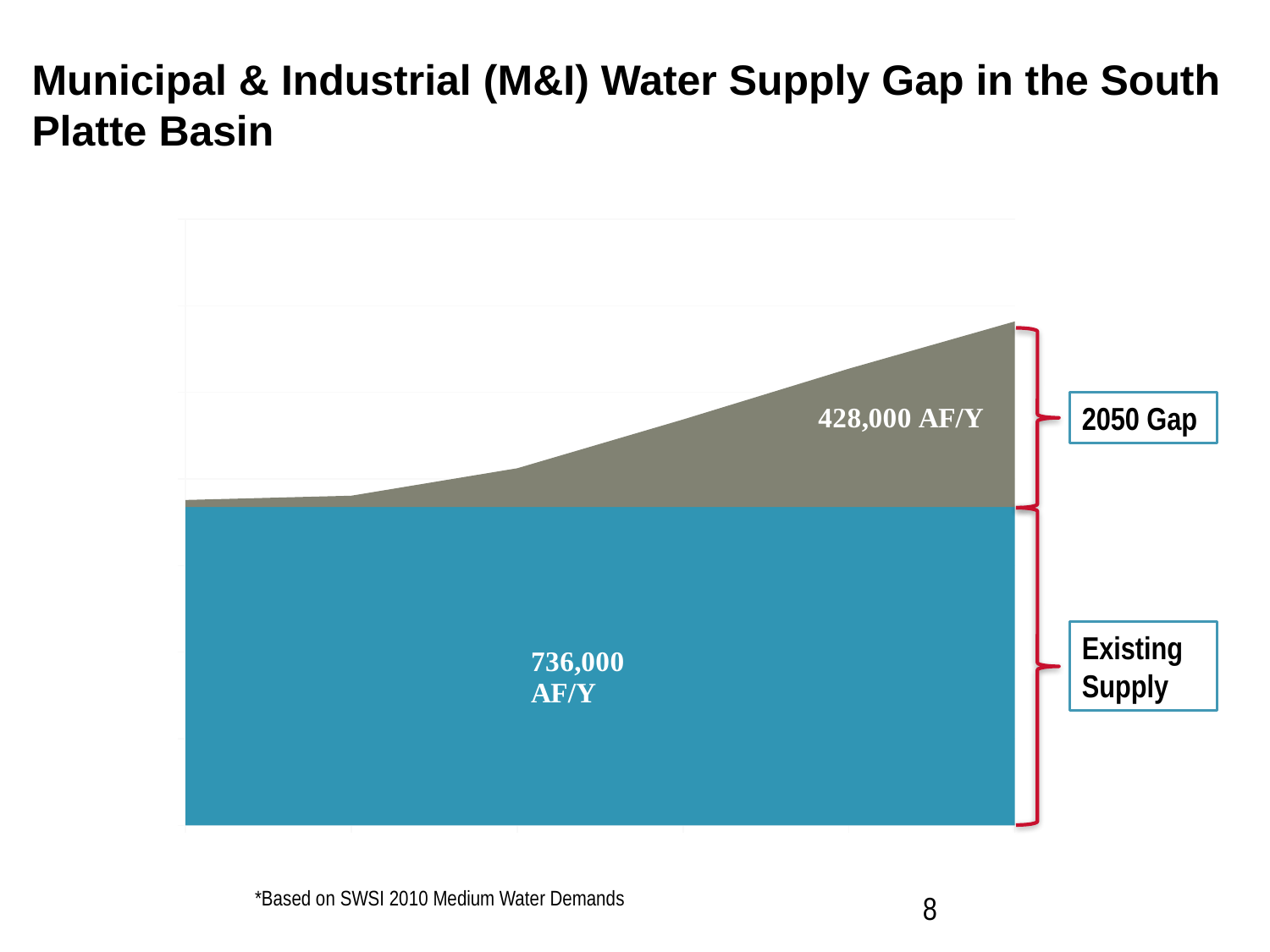
How many series are plotted on the chart? 2 What is the combined total of the Existing Supply and the 2050 Gap shown on the chart? 1,164,000 AF/Y Which is larger, the Existing Supply or the 2050 Gap? Existing Supply What is the title of the slide containing the chart? Municipal & Industrial (M&I) Water Supply Gap in the South Platte Basin What kind of chart is shown on the slide? area chart What is the value labelled for Existing Supply on the chart? 736,000 AF/Y Which series is shown in blue on the chart? Existing Supply By how much does the Existing Supply exceed the 2050 Gap? 308,000 AF/Y Does the gap area rise or fall moving left to right along the x axis? rises What is the value labelled for the 2050 Gap on the chart? 428,000 AF/Y